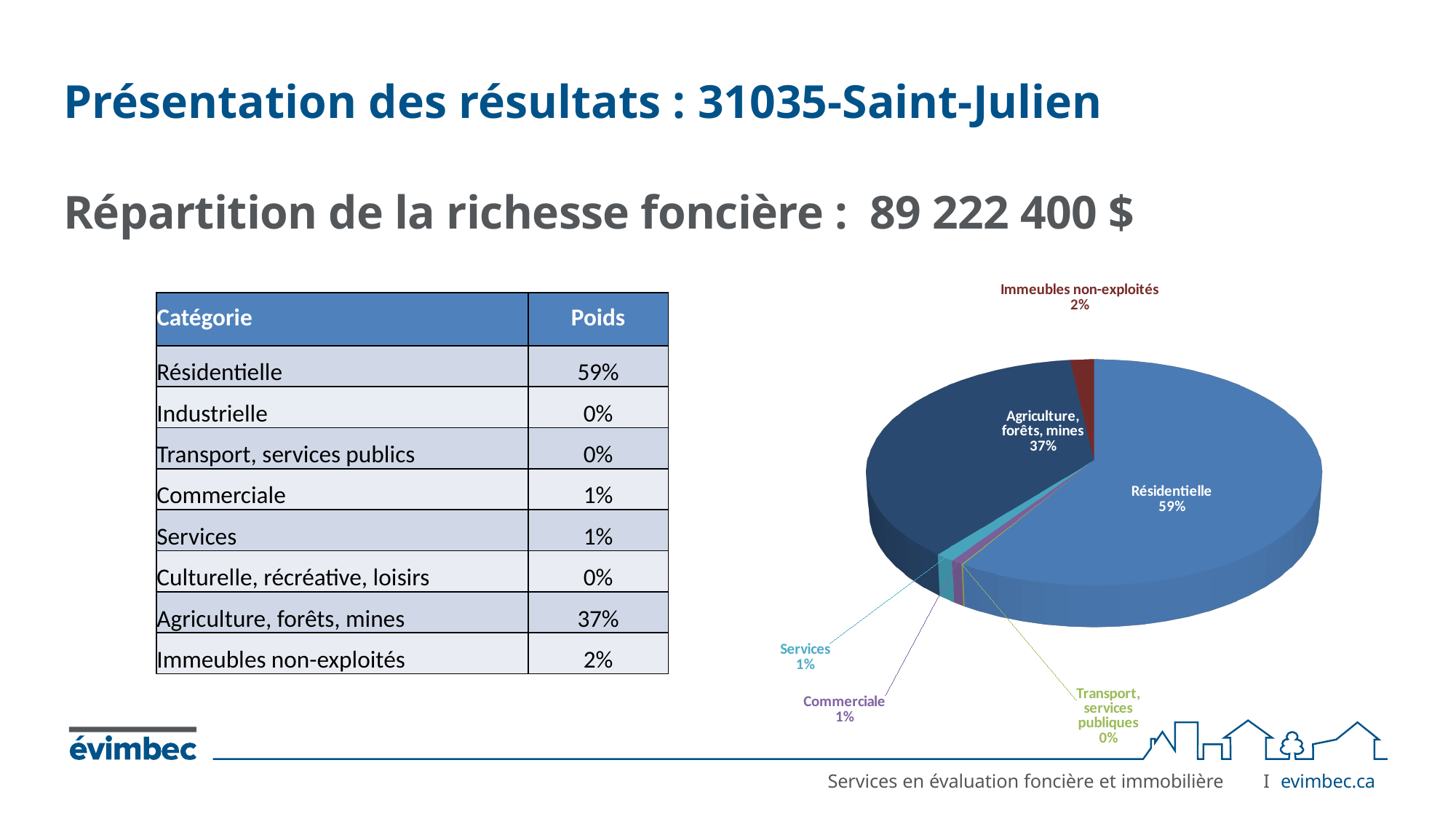
Which is larger in the pie chart: Agriculture, forêts, mines or Immeubles non-exploités? Agriculture, forêts, mines By how many percentage points does Résidentielle exceed Agriculture, forêts, mines in the pie chart? 22 What value does the pie chart show for Services? 1% Which labelled category has the smallest share in the pie chart? Transport, services publiques What share of the pie chart does the Résidentielle slice represent? 59% Which category has the largest slice in the pie chart? Résidentielle What value does the pie chart show for Commerciale? 1% What percentage is labelled for Immeubles non-exploités in the pie chart? 2% What is the value shown for Agriculture, forêts, mines in the pie chart? 37% What total amount of richesse foncière is stated in the heading above the chart? 89 222 400 $ What type of chart is shown on the slide? Pie chart What percentage is labelled for Transport, services publiques in the pie chart? 0%